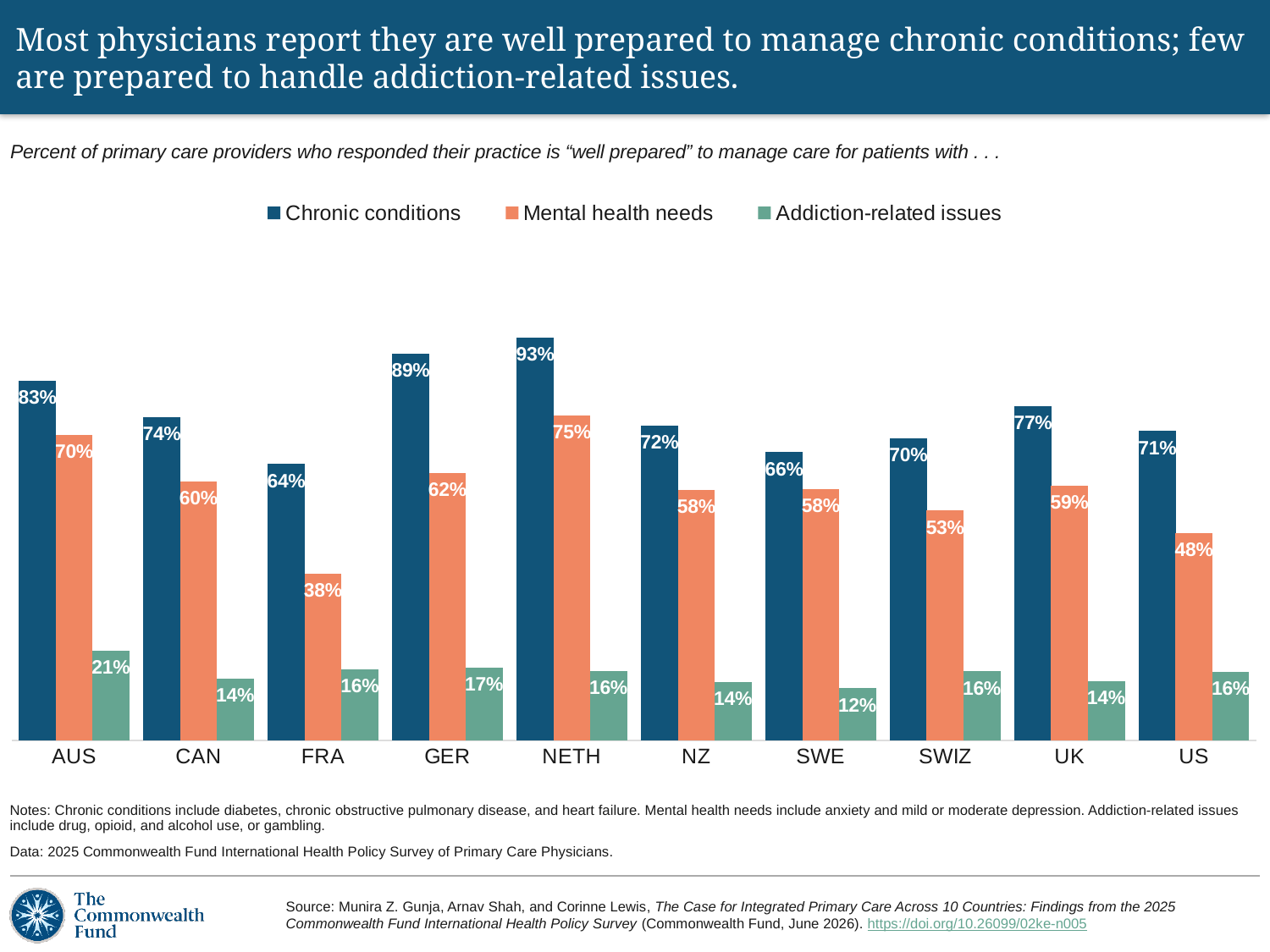
What is the value for Mental health needs in France? 38% Which country has the highest value for Addiction-related issues? AUS Which country has the highest value for Chronic conditions? NETH Which series is shown in green in the legend? Addiction-related issues What percentage of primary care providers in Germany said their practice is well prepared to manage chronic conditions? 89% How many countries are shown on the x axis? 10 Which is larger: the Mental health needs value for Canada or for the UK? Canada What is the value for Addiction-related issues in Sweden? 12% What is the difference between the Chronic conditions value and the Mental health needs value for the US? 23% What kind of chart is shown on the slide? Bar chart How many series does the legend list? 3 Which country has the lowest value for Mental health needs? FRA